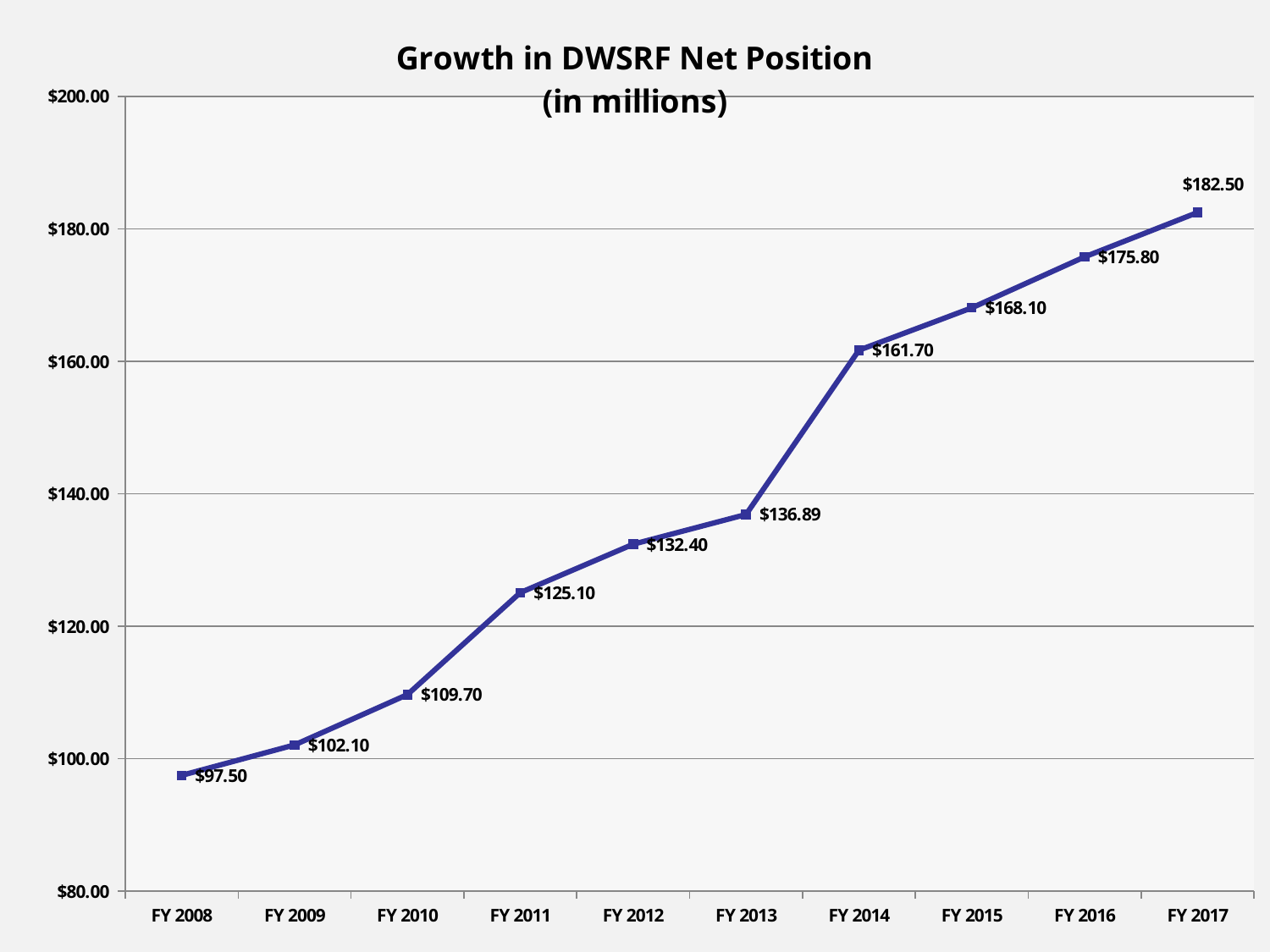
Which fiscal year has the lowest DWSRF net position? FY 2008 Do the values rise or fall from FY 2008 to FY 2017? rise Which is larger, the net position in FY 2011 or FY 2012? FY 2012 What is the DWSRF net position for FY 2008? $97.50 What is the DWSRF net position for FY 2013? $136.89 How many fiscal years are plotted on the chart? 10 What is the DWSRF net position for FY 2017? $182.50 What is the difference between the net position in FY 2017 and FY 2008? $85.00 What is the difference between the net position in FY 2014 and FY 2013? $24.81 Is the value for FY 2015 greater or less than $160.00? greater Which fiscal year has the highest DWSRF net position? FY 2017 What kind of chart is shown on the slide? line chart